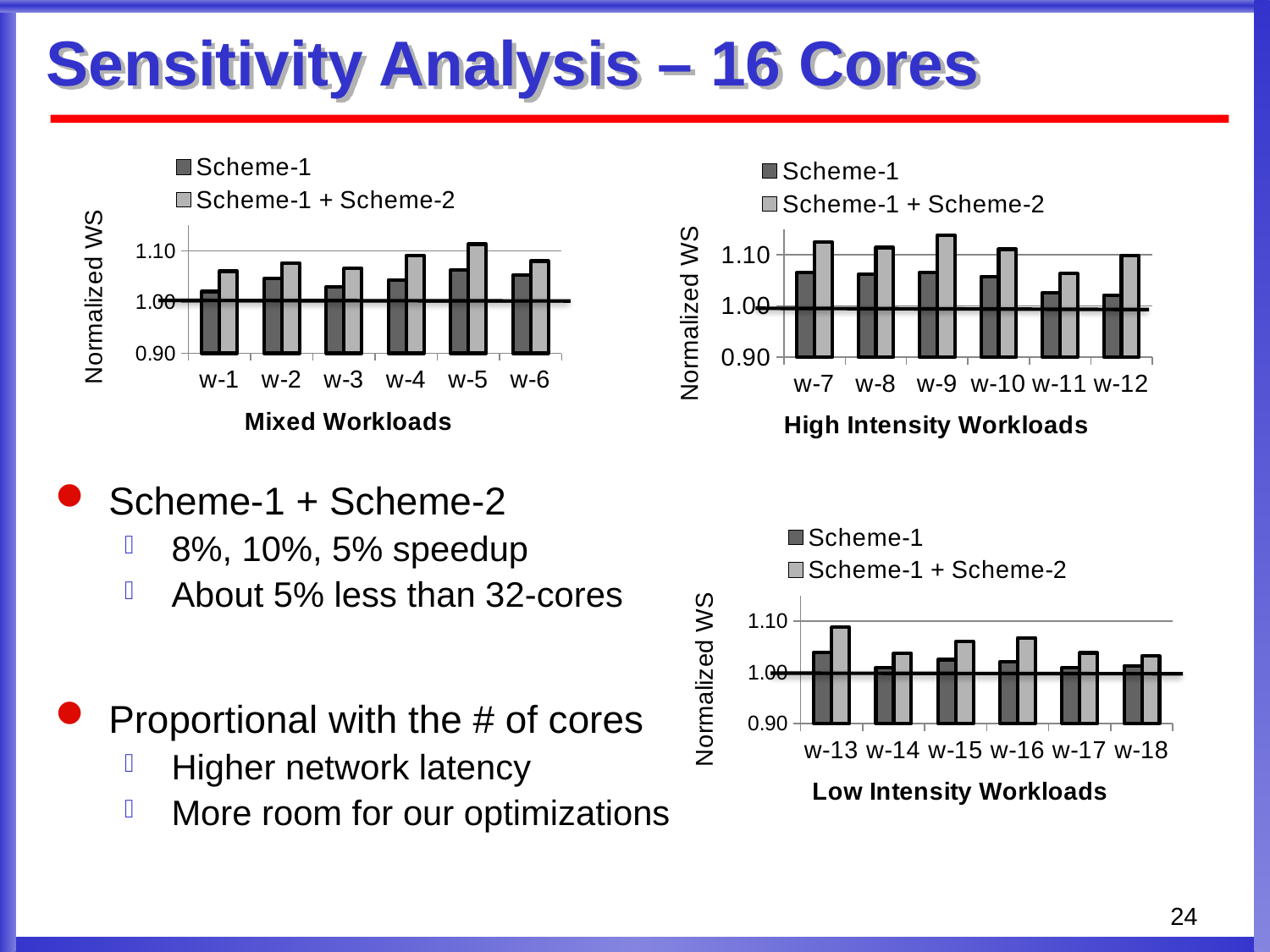
In the Mixed Workloads chart, is the Scheme-1 value for w-1 greater or less than 1.10? less What is the y-axis title of the High Intensity Workloads chart? Normalized WS In the Mixed Workloads chart, is the Scheme-1 + Scheme-2 value for w-5 greater or less than 1.10? greater In the Low Intensity Workloads chart, is the Scheme-1 + Scheme-2 value for w-16 greater or less than 1.10? less What are the two legend entries in the Low Intensity Workloads chart? Scheme-1; Scheme-1 + Scheme-2 How many series does the legend of the High Intensity Workloads chart list? 2 What kind of chart is the Mixed Workloads chart? bar chart In the Mixed Workloads chart, which is larger for Scheme-1 + Scheme-2: w-1 or w-5? w-5 In the Mixed Workloads chart, which workload has the highest Scheme-1 + Scheme-2 value? w-5 How many workload categories are shown on the x axis of the Low Intensity Workloads chart? 6